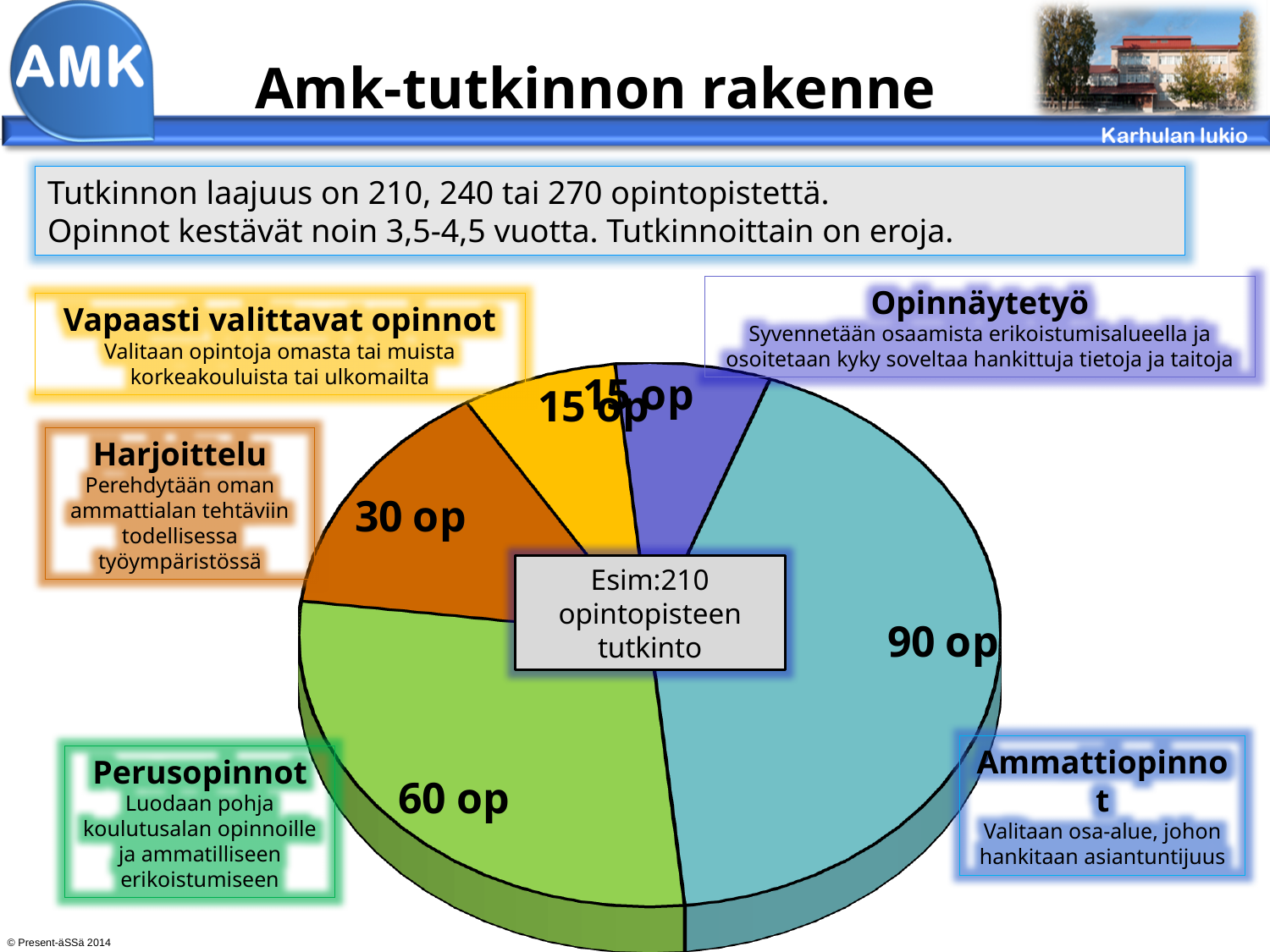
How many credits (op) does the Ammattiopinnot slice represent? 90 op What total number of credits does the example degree in the pie chart represent? 210 How many credits (op) does the Perusopinnot slice represent? 60 op What is the value of the smallest slices in the pie chart? 15 op What colour is the Perusopinnot slice of the pie chart? green How many credits (op) does the Harjoittelu slice represent? 30 op How many slices does the pie chart have? 5 Which slice of the pie chart is the largest? Ammattiopinnot (90 op) What is the value of the largest slice in the pie chart? 90 op What is the difference in credits between the Ammattiopinnot slice and the Perusopinnot slice? 30 op Which slice is larger, Perusopinnot or Harjoittelu? Perusopinnot What kind of chart is shown on the slide? pie chart